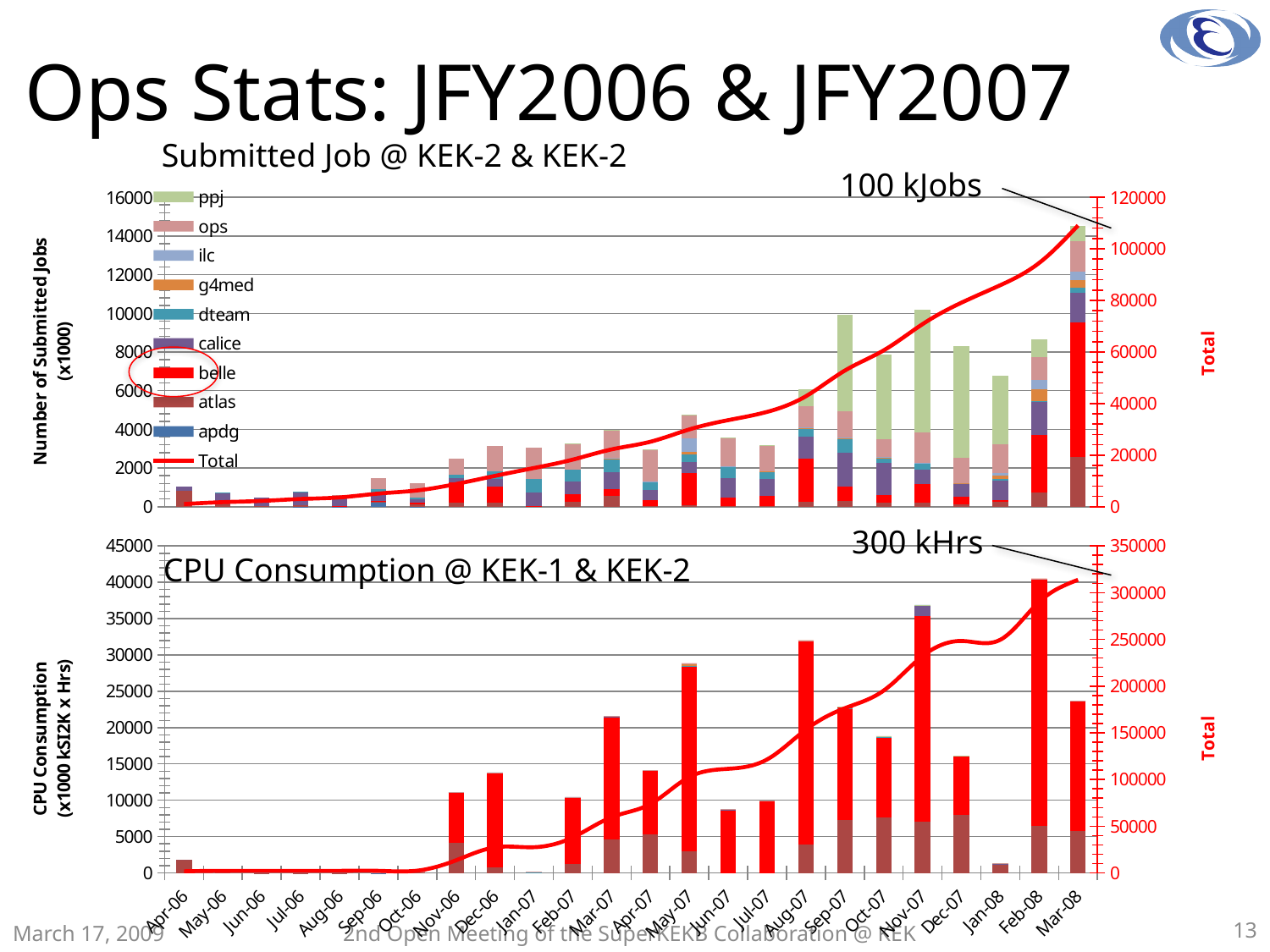
How many months are shown along the x axis of the bottom chart, 'CPU Consumption @ KEK-1 & KEK-2'? 24 In the top chart, which month has the tallest stacked bar? Mar-08 How many series does the legend of the top chart list? 10 In the top chart, which stacked bar is taller, Sep-07 or Oct-07? Sep-07 In the bottom chart, which bar is taller, Aug-07 or Oct-07? Aug-07 In the top chart, is the stacked bar for Mar-08 greater or less than 12000? greater In the bottom chart, which month has the tallest bar? Feb-08 In the bottom chart, is the bar for Jun-07 greater or less than 10000? less In the top chart, does the red Total line generally rise or fall from Apr-06 to Mar-08? Rise In the bottom chart, is the bar for Feb-08 greater or less than 35000? greater What type of chart is the top chart, 'Submitted Job @ KEK-2 & KEK-2'? Stacked bar chart with a line In the top chart's legend, which series name is circled? belle